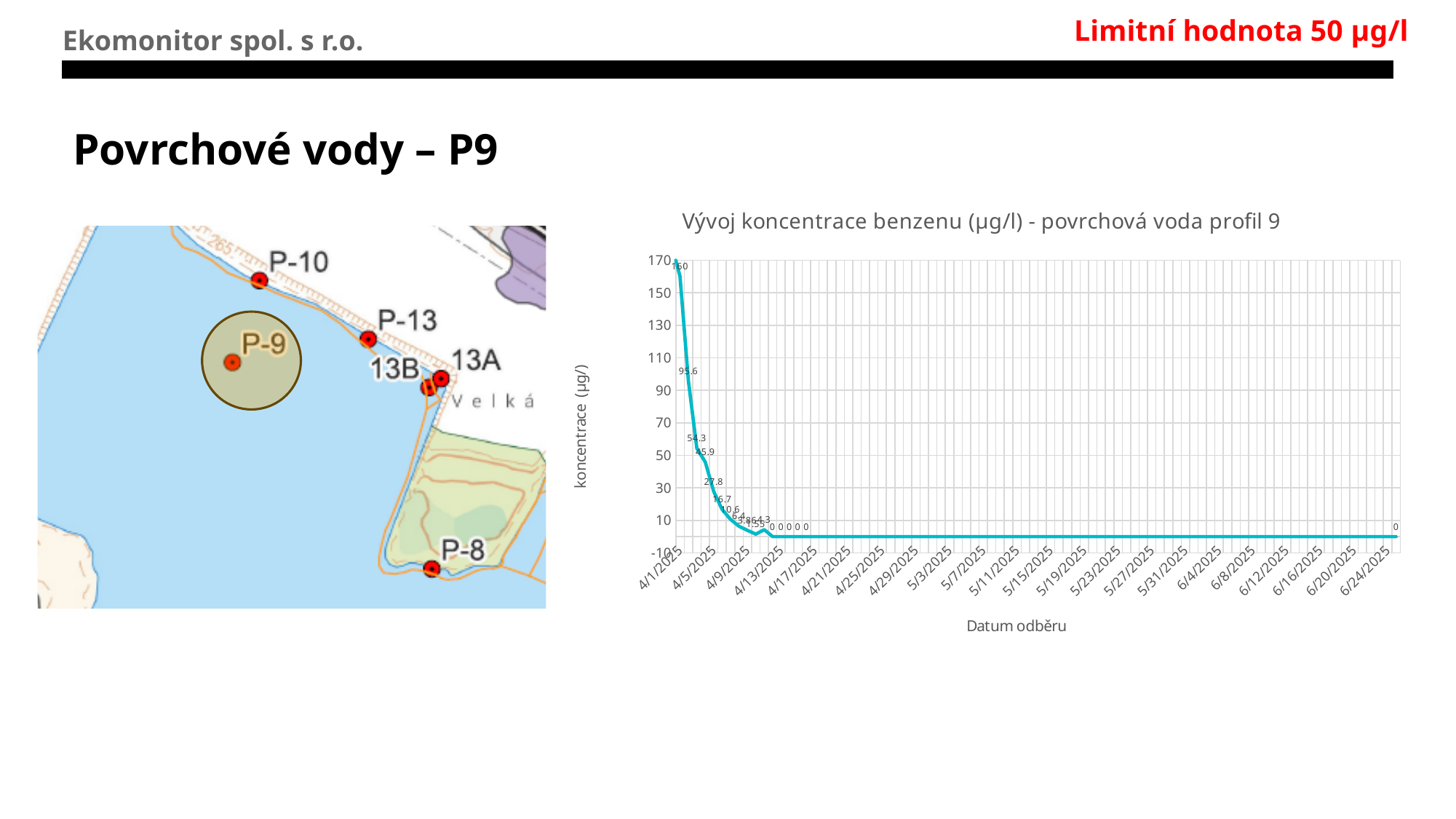
Is the concentration value at 5/3/2025 greater or less than 10? less Which of the labelled values 54.3 and 45.9 is larger? 54.3 What is the title of the chart? Vývoj koncentrace benzenu (µg/l) - povrchová voda profil 9 What kind of chart is shown on the slide? line chart Do the concentration values rise or fall along the x axis over time? fall What is the lowest concentration value labelled on the chart? 0 What is the concentration value labelled at the last date, 6/24/2025? 0 What is the difference between the first two labelled values, 160 and 95.6? 64.4 Is the peak concentration value on the chart greater or less than 150? greater What is the highest benzene concentration value labelled on the chart? 160 What is the concentration value labelled at the first date, 4/1/2025? 160 What is the label of the vertical axis of the chart? koncentrace (µg/l)